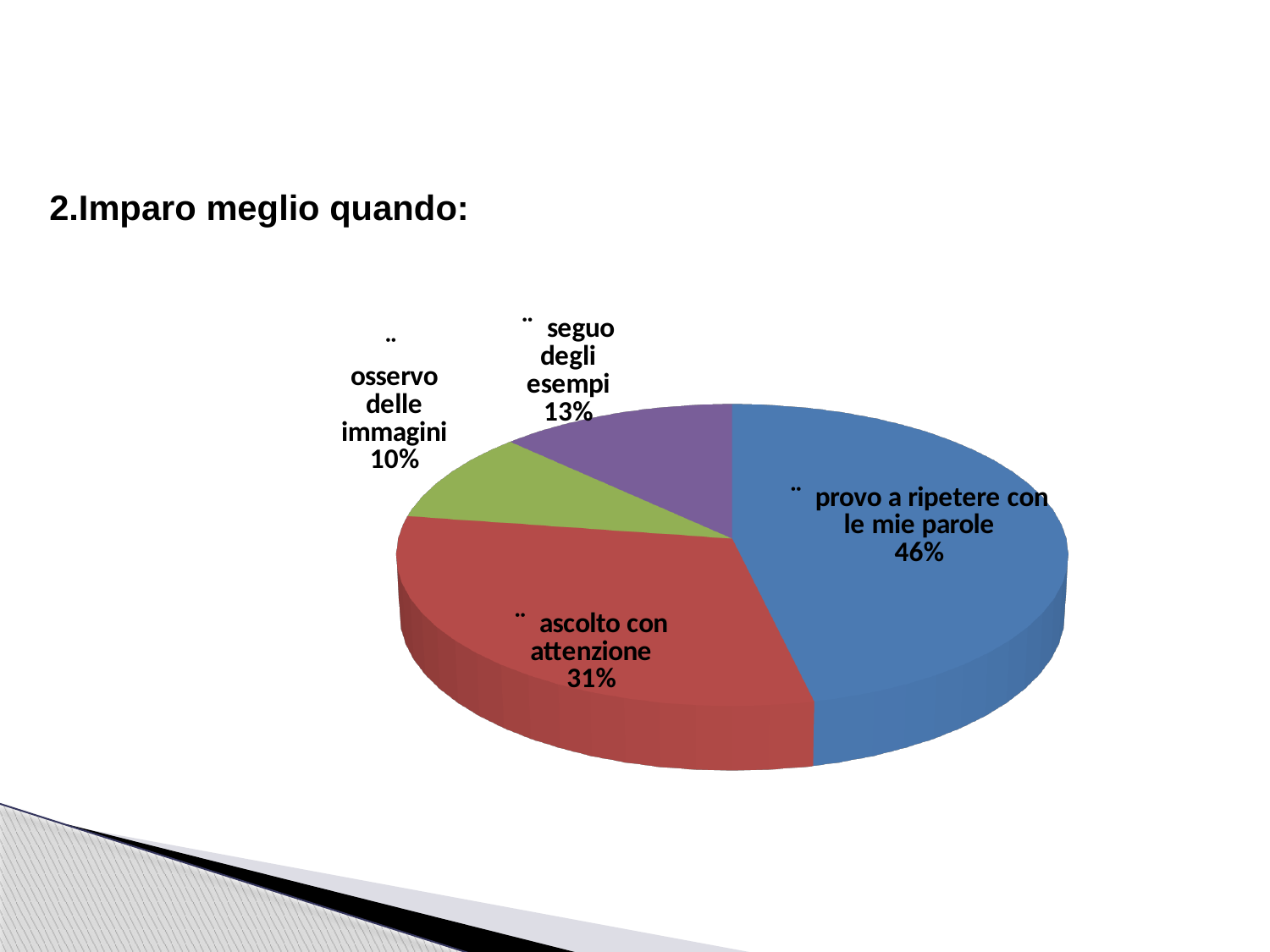
How many slices does the pie chart have? 4 What is the title of the slide above the chart? 2.Imparo meglio quando: What share of the pie does "provo a ripetere con le mie parole" have? 46% Which is larger: the share for "seguo degli esempi" or the share for "osservo delle immagini"? seguo degli esempi Which category has the smallest slice of the pie? osservo delle immagini What share of the pie does "seguo degli esempi" have? 13% Which category has the largest slice of the pie? provo a ripetere con le mie parole What share of the pie does "ascolto con attenzione" have? 31% What colour is the slice for "ascolto con attenzione"? red What kind of chart is shown on the slide? pie chart What is the difference in percentage points between "provo a ripetere con le mie parole" and "ascolto con attenzione"? 15%